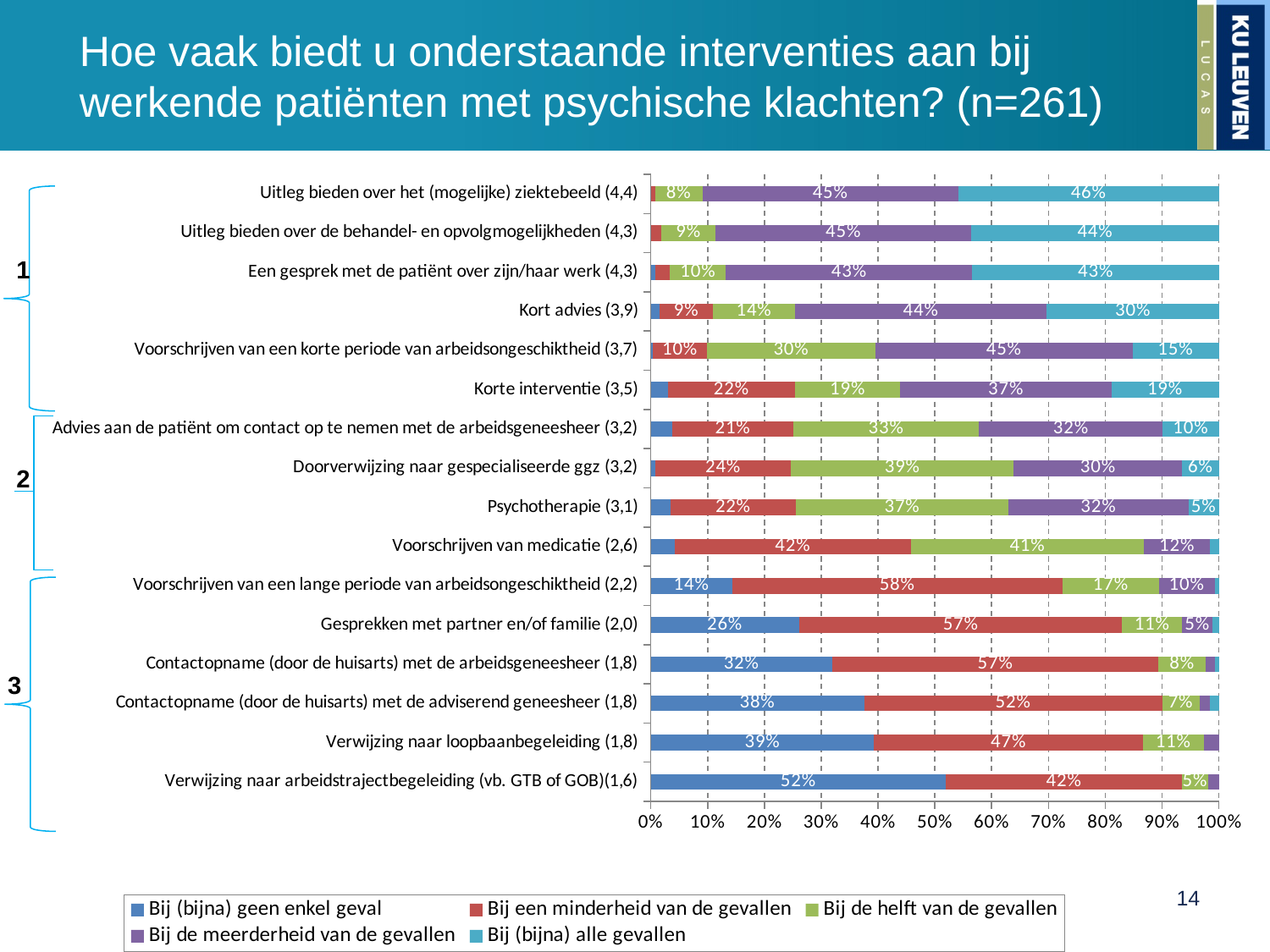
What percentage of respondents offer 'Uitleg bieden over het (mogelijke) ziektebeeld' in 'Bij (bijna) alle gevallen'? 46% How many series does the legend list? 5 Which intervention has the highest 'Bij (bijna) alle gevallen' share? Uitleg bieden over het (mogelijke) ziektebeeld What is the 'Bij een minderheid van de gevallen' value for 'Voorschrijven van een lange periode van arbeidsongeschiktheid'? 58% Which colour represents 'Bij een minderheid van de gevallen' in the legend? Red Which is larger: the 'Bij de meerderheid van de gevallen' value for 'Kort advies' or for 'Korte interventie'? Kort advies What is the difference between the 'Bij (bijna) geen enkel geval' values for 'Verwijzing naar loopbaanbegeleiding' and 'Contactopname (door de huisarts) met de arbeidsgeneesheer'? 7% How many interventions (categories) are plotted in the chart? 16 What is the 'Bij de helft van de gevallen' value for 'Doorverwijzing naar gespecialiseerde ggz'? 39% Which intervention has the highest 'Bij (bijna) geen enkel geval' share? Verwijzing naar arbeidstrajectbegeleiding (vb. GTB of GOB) What kind of chart is shown on the slide? Stacked bar chart What is the 'Bij (bijna) geen enkel geval' value for 'Verwijzing naar arbeidstrajectbegeleiding (vb. GTB of GOB)'? 52%